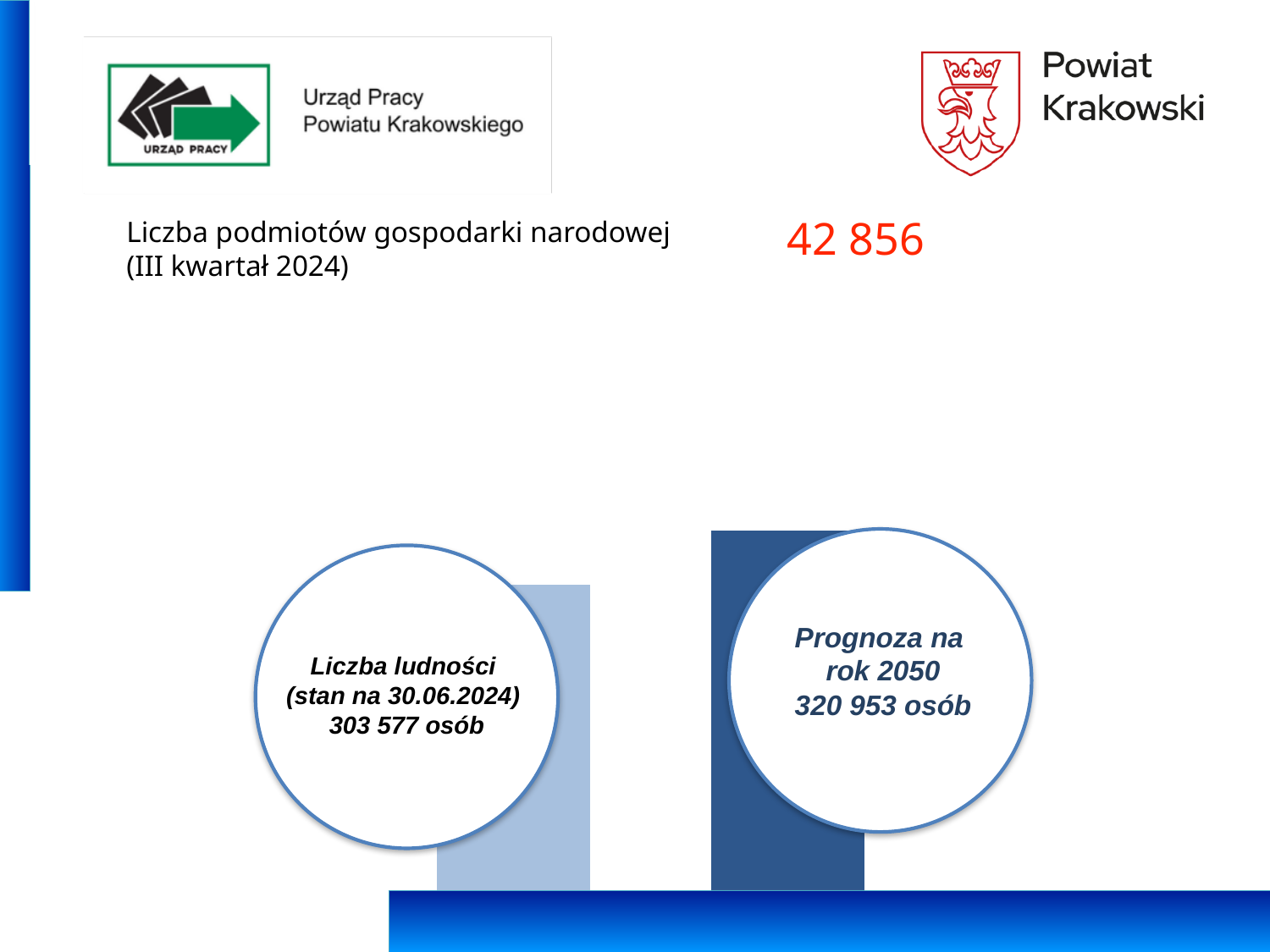
Which is larger: the population as of 30.06.2024 or the forecast for 2050? Prognoza na rok 2050 What is the number of national economy entities (III kwartał 2024) shown on the slide? 42 856 What colour is the bar for the population as of 30.06.2024? light blue What colour is the bar for the 2050 forecast? dark blue How many bars are shown in the population graphic at the bottom of the slide? 2 What is the population figure shown for 30.06.2024? 303 577 osób Does the population value rise or fall from 30.06.2024 to the 2050 forecast? rise By how many people does the 2050 forecast exceed the population as of 30.06.2024? 17 376 Which bar in the population graphic is taller, the left one (30.06.2024) or the right one (2050 forecast)? the right one (2050 forecast) What kind of chart is the population graphic at the bottom of the slide? bar chart What is the forecast population for the year 2050 shown on the slide? 320 953 osób